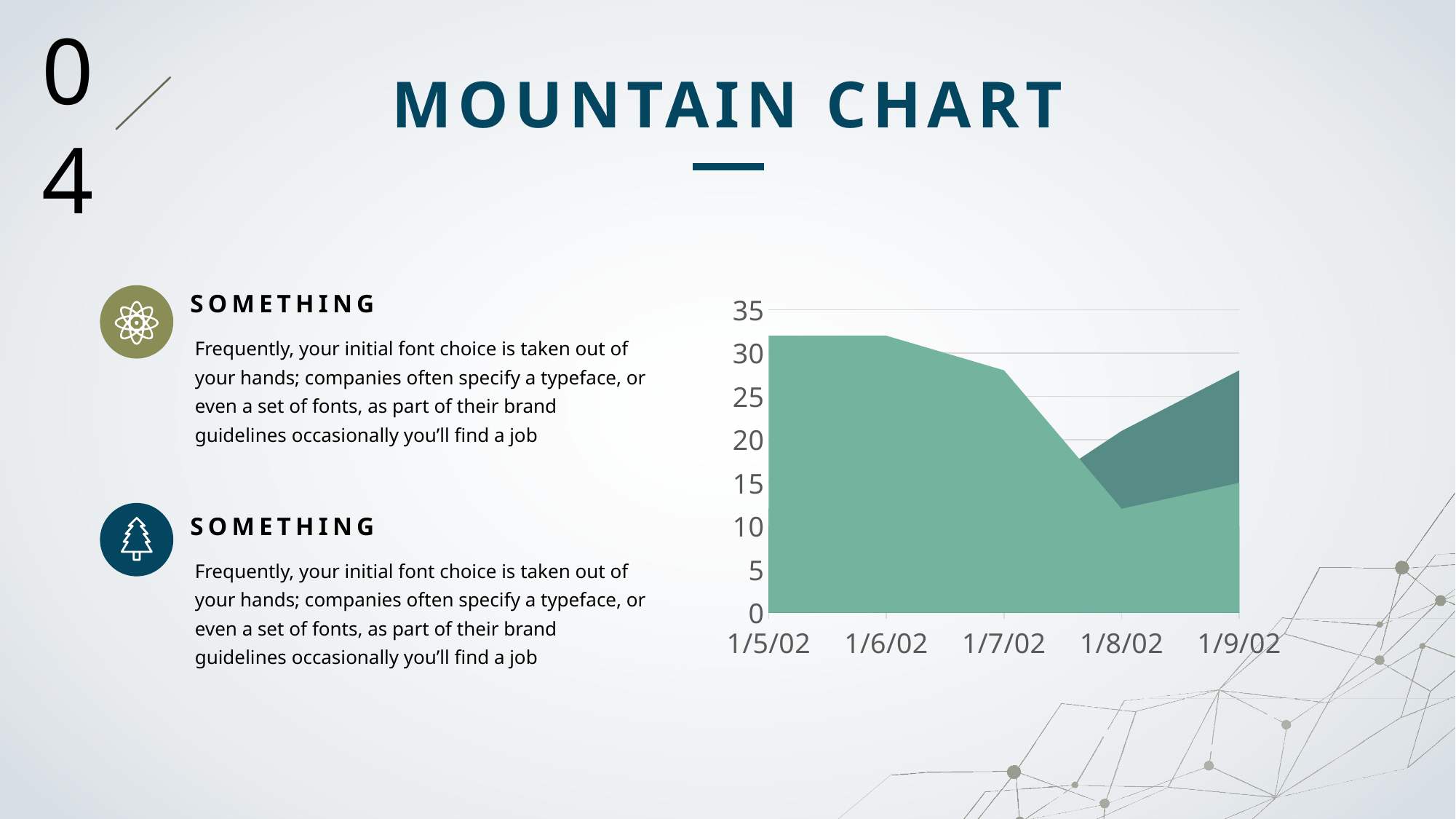
Is the value of the light green area at 1/5/02 greater or less than 30? greater What is the highest tick value shown on the y axis of the chart? 35 Which date has the lowest value for the light green area? 1/8/02 Does the light green area rise or fall between 1/5/02 and 1/8/02? fall How many dates are labelled along the x axis of the chart? 5 What kind of chart is shown on the slide? Area chart What is the title of the slide containing the chart? MOUNTAIN CHART Is the value of the light green area at 1/7/02 greater or less than 25? greater Which is larger for the light green area: the value at 1/5/02 or the value at 1/8/02? 1/5/02 Is the value of the light green area at 1/8/02 greater or less than 15? less What is the first date label on the x axis of the chart? 1/5/02